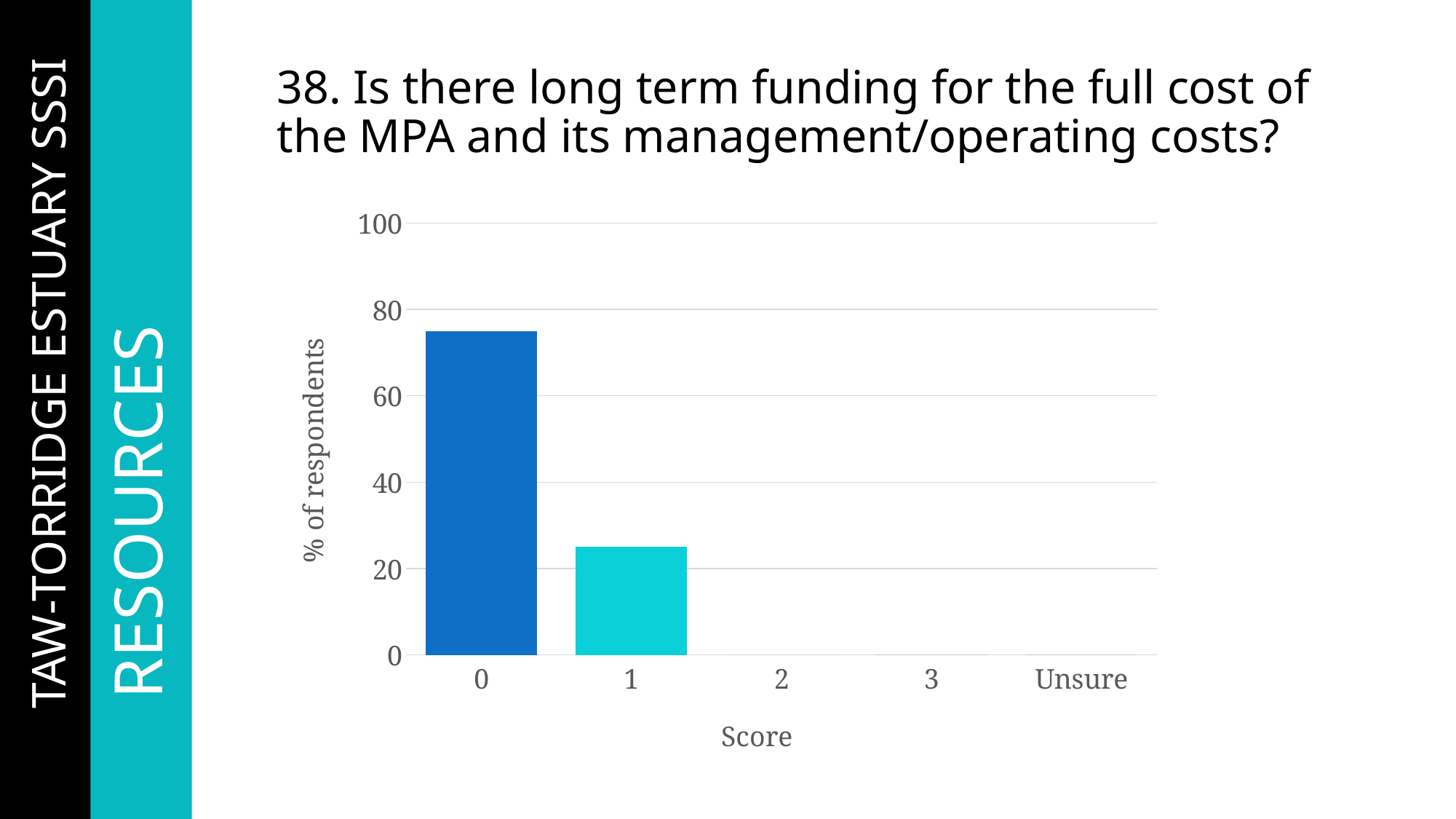
What is the label on the x axis? Score What kind of chart is shown on the slide? bar chart Is the value for score 0 greater or less than 80? less Is the value for score 1 greater or less than 40? less What is the label on the y axis? % of respondents Is the value for score 0 greater or less than 60? greater Which is larger, the value for score 0 or the value for score 1? score 0 How many score categories are shown on the x axis? 5 Which score category has the highest percentage of respondents? 0 Do the values rise or fall moving from score 0 to score 1? fall What is the percentage of respondents for score 2? 0